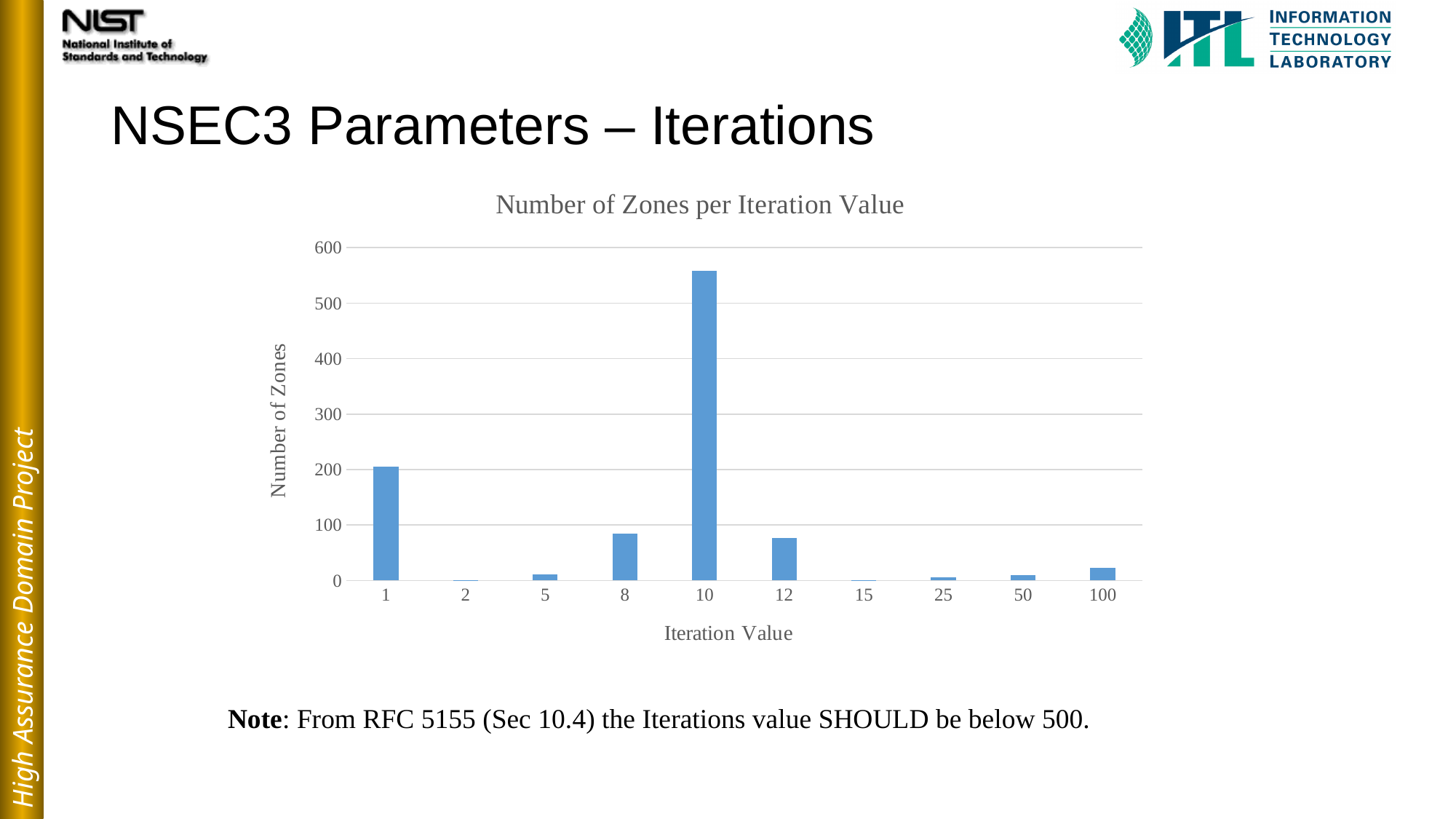
Which has more zones: iteration value 1 or iteration value 8? 1 What type of chart is shown on the slide? bar chart What is the label of the vertical axis of the chart? Number of Zones What is the title of the chart? Number of Zones per Iteration Value Is the number of zones for iteration value 1 greater or less than 300? less Is the number of zones for iteration value 1 greater or less than 100? greater Is the number of zones for iteration value 10 greater or less than 500? greater How many iteration values are shown on the x axis of the chart? 10 Which has more zones: iteration value 100 or iteration value 50? 100 Which has more zones: iteration value 12 or iteration value 25? 12 Which iteration value has the highest number of zones? 10